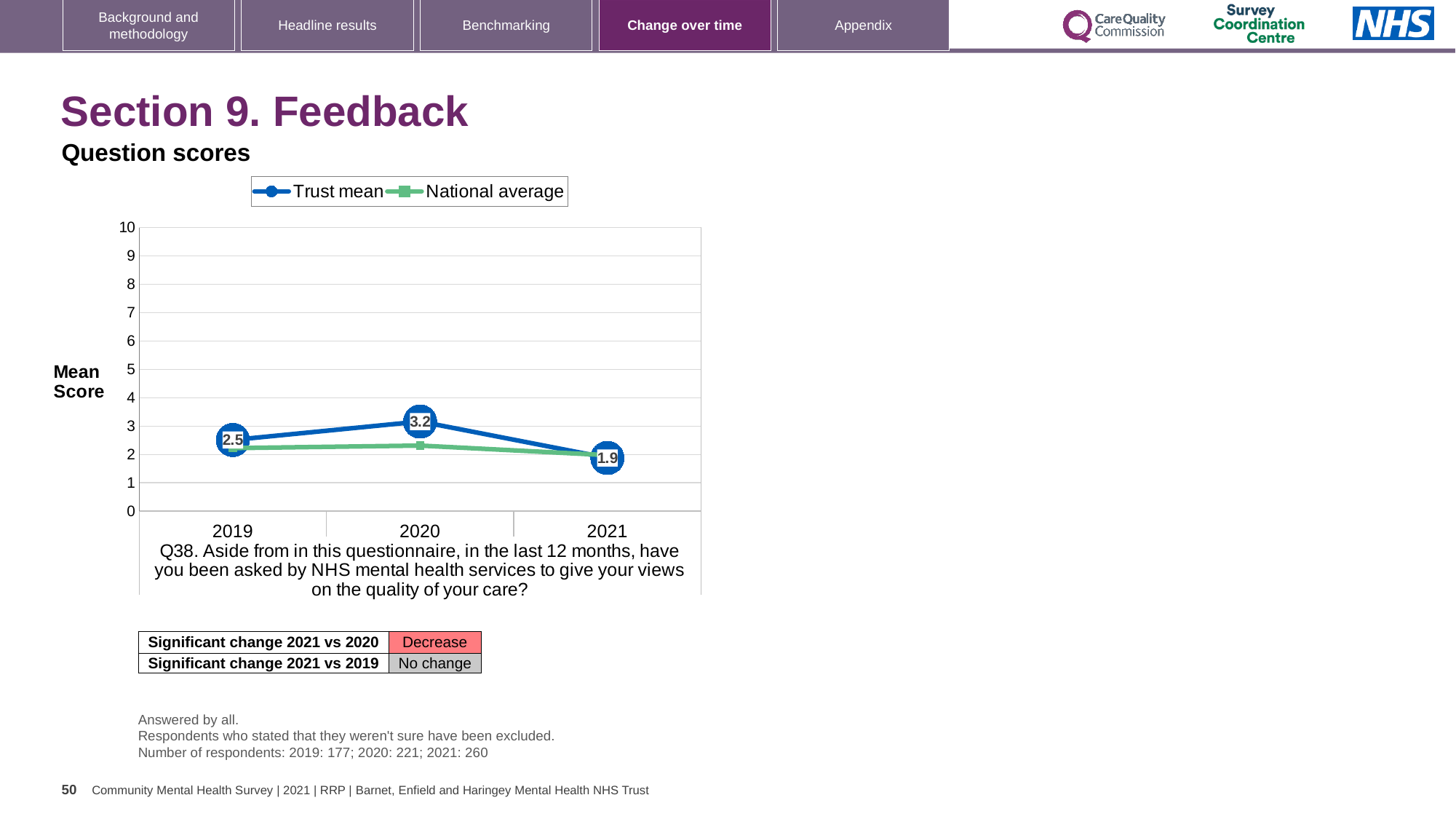
What is the Trust mean score for 2021? 1.9 In which year is the Trust mean score highest? 2020 Is the National average score for 2020 greater or less than 3? less How many series does the legend list? 2 What kind of chart is shown on the slide? line chart What is the difference between the Trust mean scores for 2020 and 2021? 1.3 What is the Trust mean score for 2020? 3.2 Does the Trust mean score rise or fall from 2020 to 2021? fall In which year is the Trust mean score lowest? 2021 How many years are plotted on the x axis? 3 What is the Trust mean score for 2019? 2.5 Which is larger, the Trust mean score for 2019 or for 2020? 2020